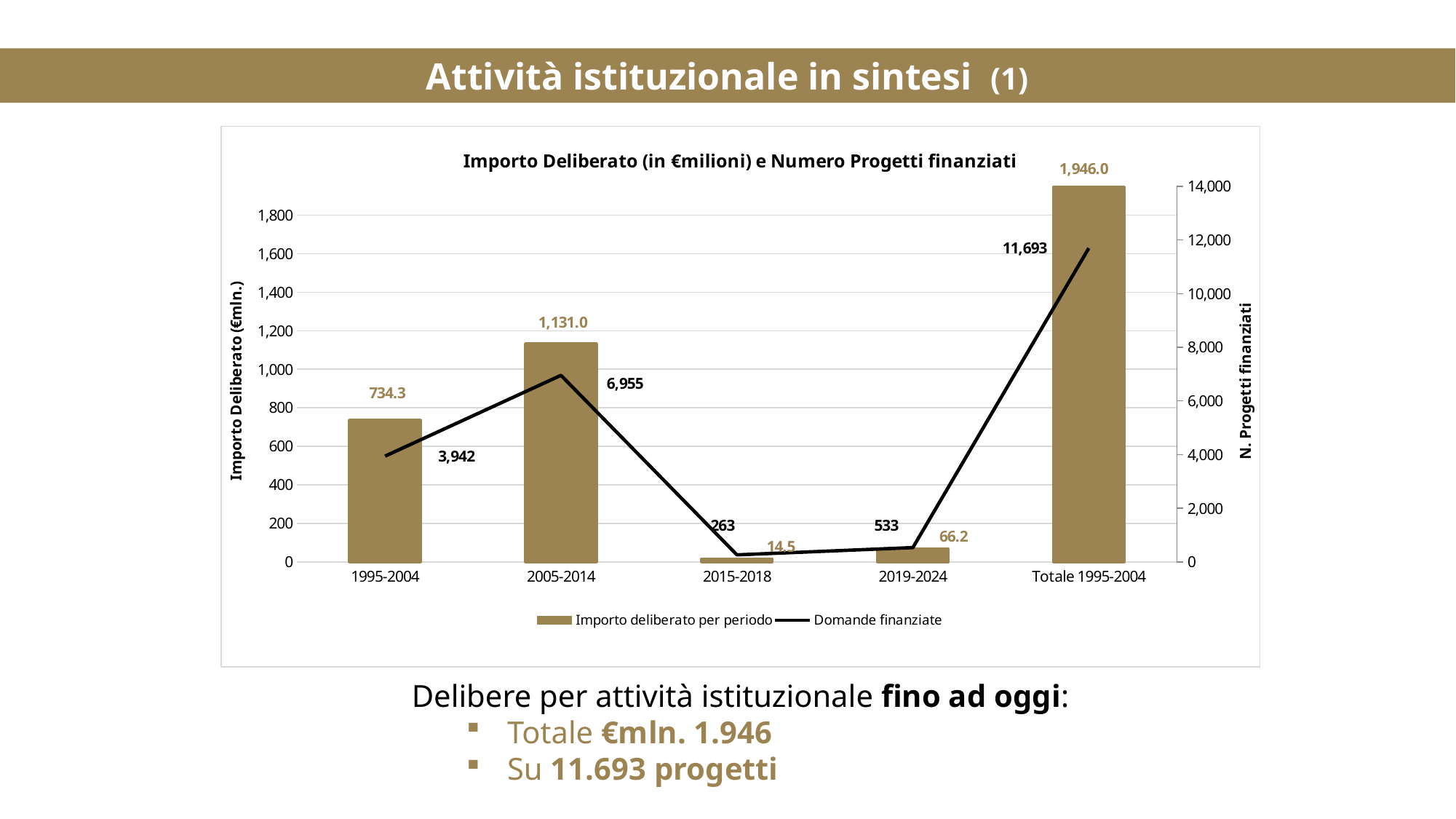
Which category has the lowest 'Domande finanziate' value? 2015-2018 Among the individual periods (excluding the total), which has the highest 'Importo deliberato per periodo'? 2005-2014 How many categories are shown on the x axis? 5 What kind of chart is this? Combination bar and line chart How many series does the legend list? 2 What is the title of the chart? Importo Deliberato (in €milioni) e Numero Progetti finanziati What is the value of 'Importo deliberato per periodo' for 2019-2024? 66.2 Which is larger: 'Domande finanziate' for 2015-2018 or for 2019-2024? 2019-2024 What is the value of 'Importo deliberato per periodo' for 2005-2014? 1,131.0 What is the value of 'Domande finanziate' for Totale 1995-2004? 11,693 What is the difference between the 'Importo deliberato per periodo' values for 2005-2014 and 1995-2004? 396.7 What is the value of 'Domande finanziate' for 1995-2004? 3,942